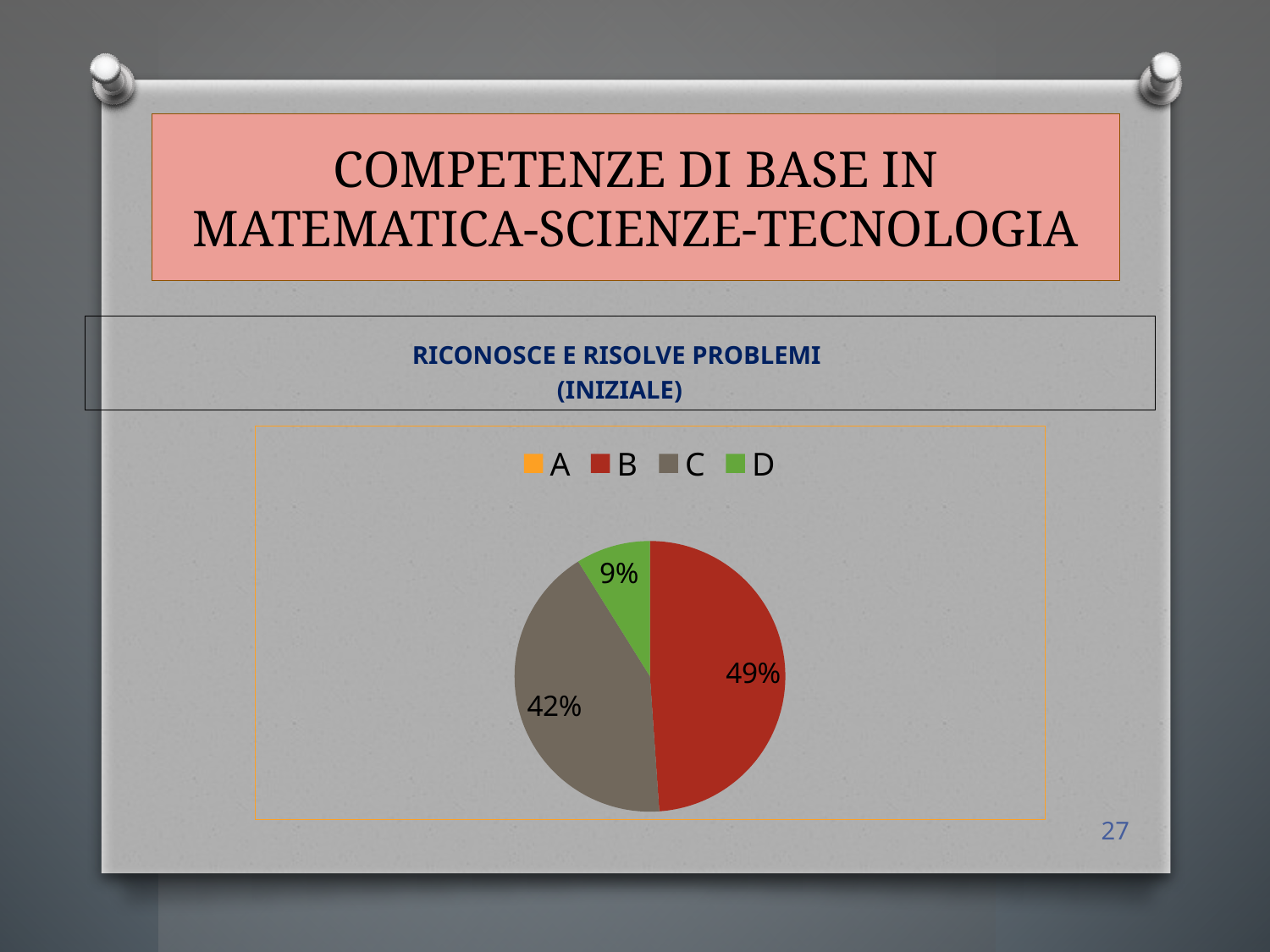
What is the difference in percentage points between slice C and slice D? 33% Which category has the largest slice in the pie chart? B What is the difference in percentage points between slice B and slice C? 7% Which is larger, slice B or slice C? B What percentage does slice D represent in the pie chart? 9% What percentage does slice B represent in the pie chart? 49% How many entries does the legend of the pie chart list? 4 What percentage does slice C represent in the pie chart? 42% What is the title shown above the pie chart? RICONOSCE E RISOLVE PROBLEMI (INIZIALE) Which labelled slice is the smallest in the pie chart? D What kind of chart is shown on the slide? pie chart What colour is slice B in the pie chart? red